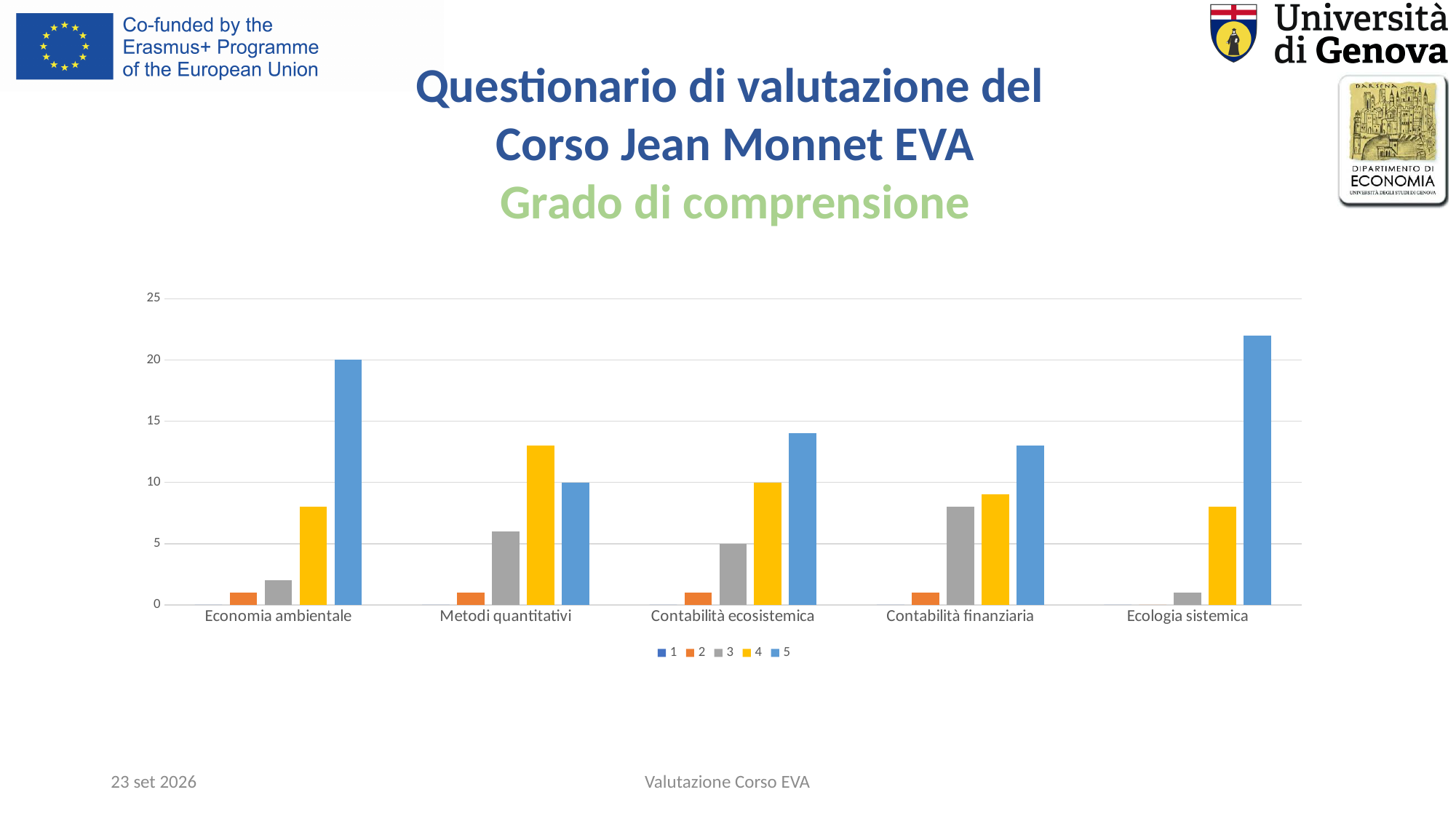
How many series does the chart legend list? 5 Is the value of series 5 for Ecologia sistemica greater or less than 20? greater What is the value of series 4 for Contabilità ecosistemica? 10 What is the value of series 5 for Economia ambientale? 20 Which category has the highest value for series 5? Ecologia sistemica What is the value of series 5 for Metodi quantitativi? 10 What is the value of series 3 for Contabilità ecosistemica? 5 How many categories are shown on the x axis of the chart? 5 What is the title of the chart section shown in green on the slide? Grado di comprensione Is the value of series 4 for Metodi quantitativi greater or less than 10? greater What kind of chart is shown on the slide? bar chart For Metodi quantitativi, which is larger: series 4 or series 5? series 4